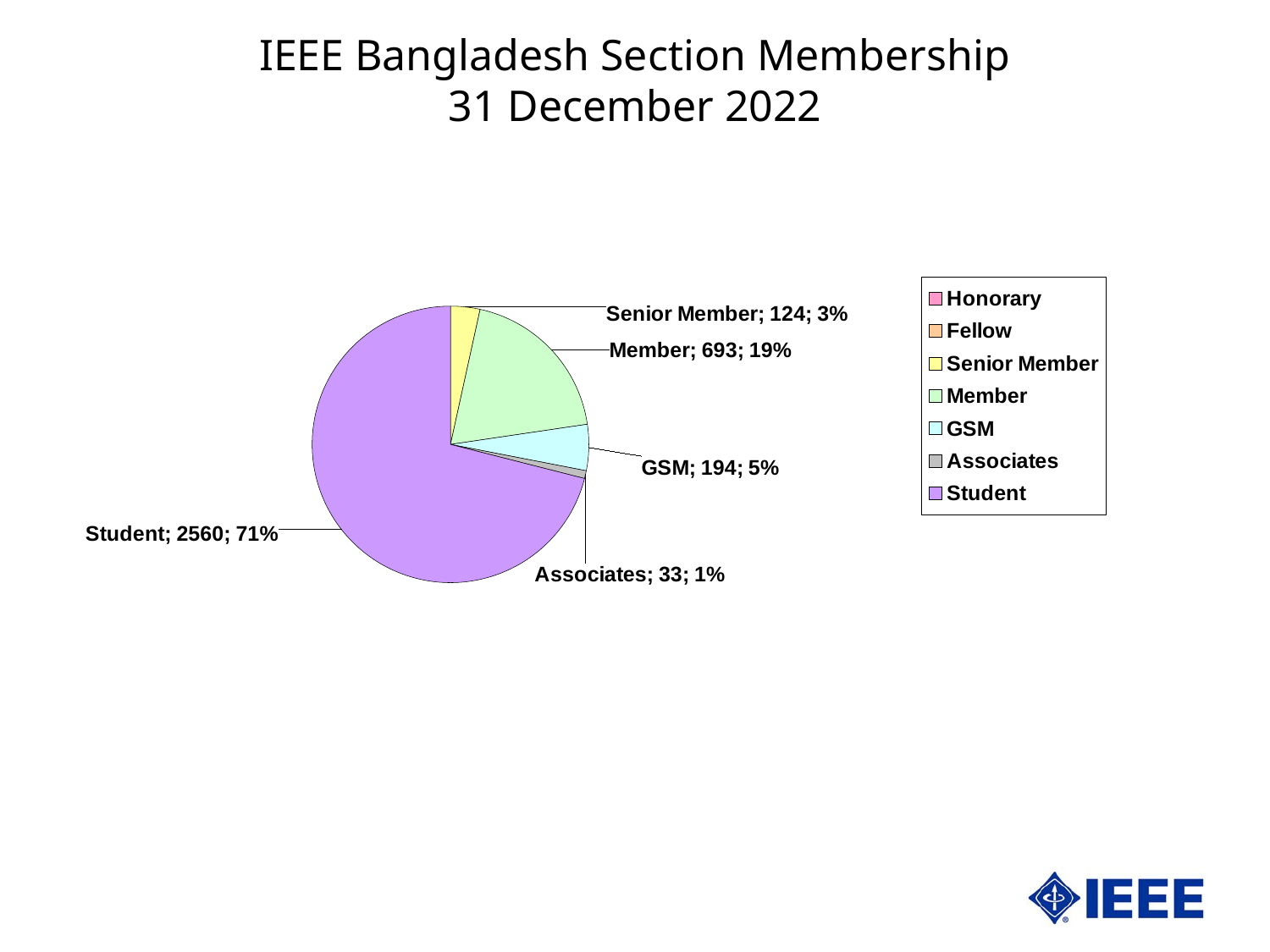
How many categories does the legend list? 7 What is the number of Student members shown on the pie chart? 2560 What is the value shown for Member on the pie chart? 693 What percentage share of the pie does the Member slice represent? 19% Which is larger, the GSM value or the Associates value? GSM What is the difference between the Member value and the Senior Member value? 569 What percentage share of the pie does the Student slice represent? 71% What type of chart is shown on the slide? Pie chart What is the value shown for GSM on the pie chart? 194 Which of the labeled slices is the smallest? Associates What is the value shown for Senior Member on the pie chart? 124 Which category has the largest slice of the pie? Student